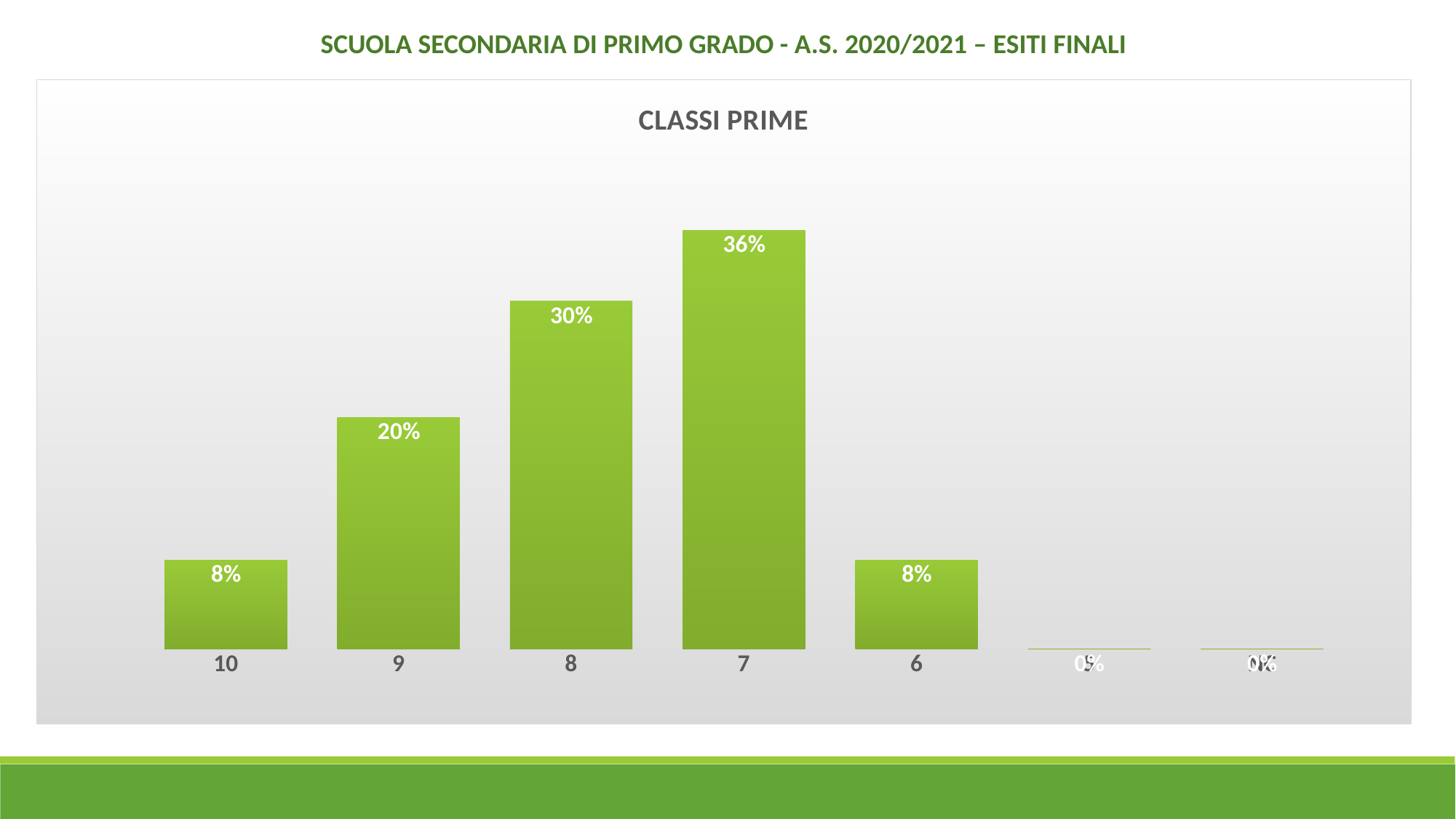
What is the value for category 7 in the CLASSI PRIME chart? 36% What is the difference between the values for categories 7 and 8 in the CLASSI PRIME chart? 6% Which category has the highest value in the CLASSI PRIME chart? 7 What is the value for category 8 in the CLASSI PRIME chart? 30% What is the difference between the values for categories 8 and 9 in the CLASSI PRIME chart? 10% What is the value for category 9 in the CLASSI PRIME chart? 20% What colour are the bars in the CLASSI PRIME chart? green What is the value for category 10 in the CLASSI PRIME chart? 8% Which has the larger value in the CLASSI PRIME chart, category 8 or category 9? 8 How many categories in the CLASSI PRIME chart have a value greater than 0%? 5 What kind of chart is the CLASSI PRIME chart? bar chart Do the values rise or fall going from category 10 to category 7 in the CLASSI PRIME chart? rise